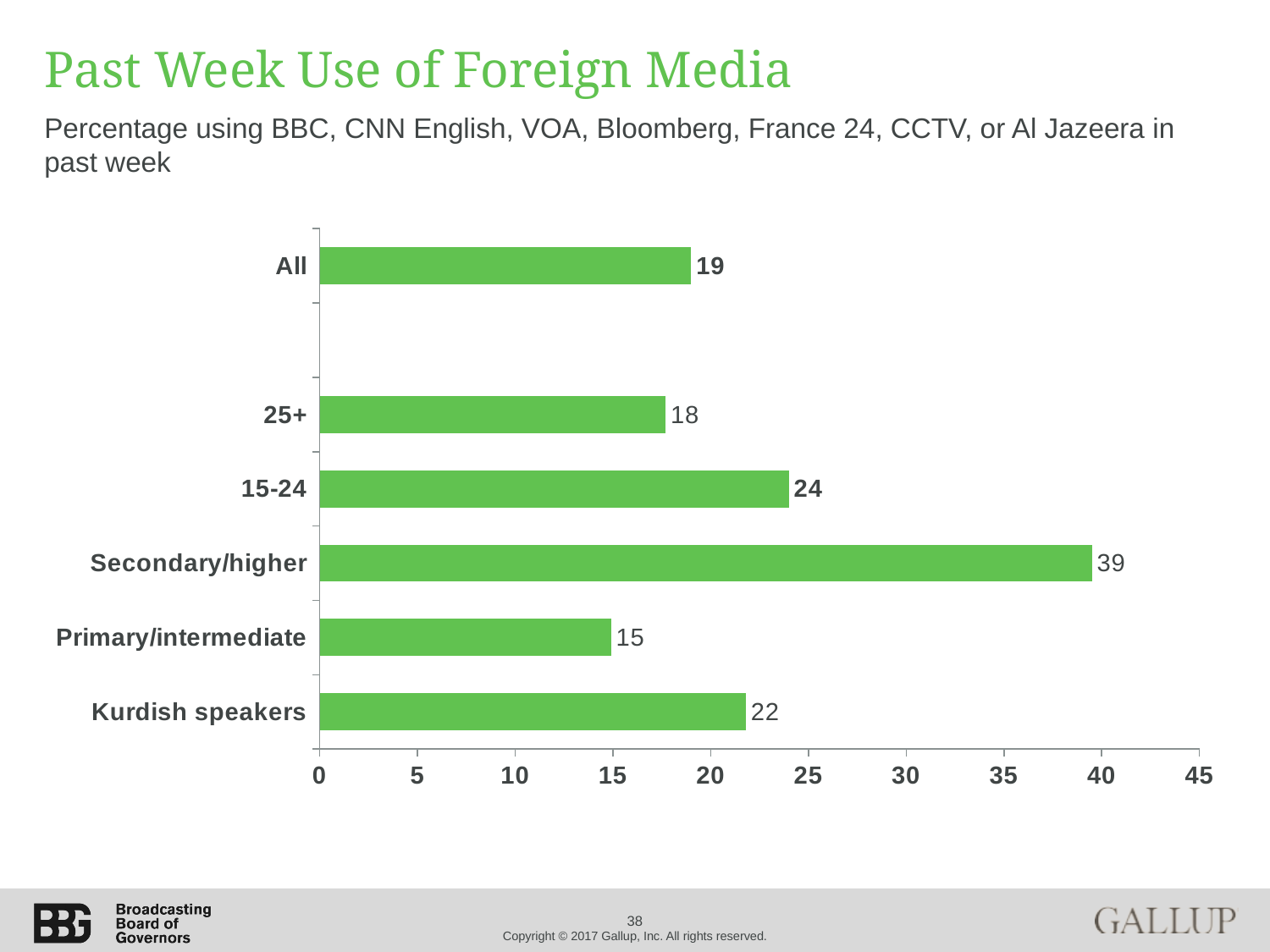
What is the value for Kurdish speakers? 22 What is the value for All? 19 What is the title of the slide? Past Week Use of Foreign Media Which is larger, the value for 15-24 or the value for 25+? 15-24 What kind of chart is shown on the slide? Bar chart Is the value for Kurdish speakers greater or less than 20? greater Which category has the lowest value? Primary/intermediate How many categories are shown in the chart? 6 What is the value for Secondary/higher? 39 Which category has the highest value? Secondary/higher What is the difference between the values for Secondary/higher and Primary/intermediate? 24 What is the value for 15-24? 24